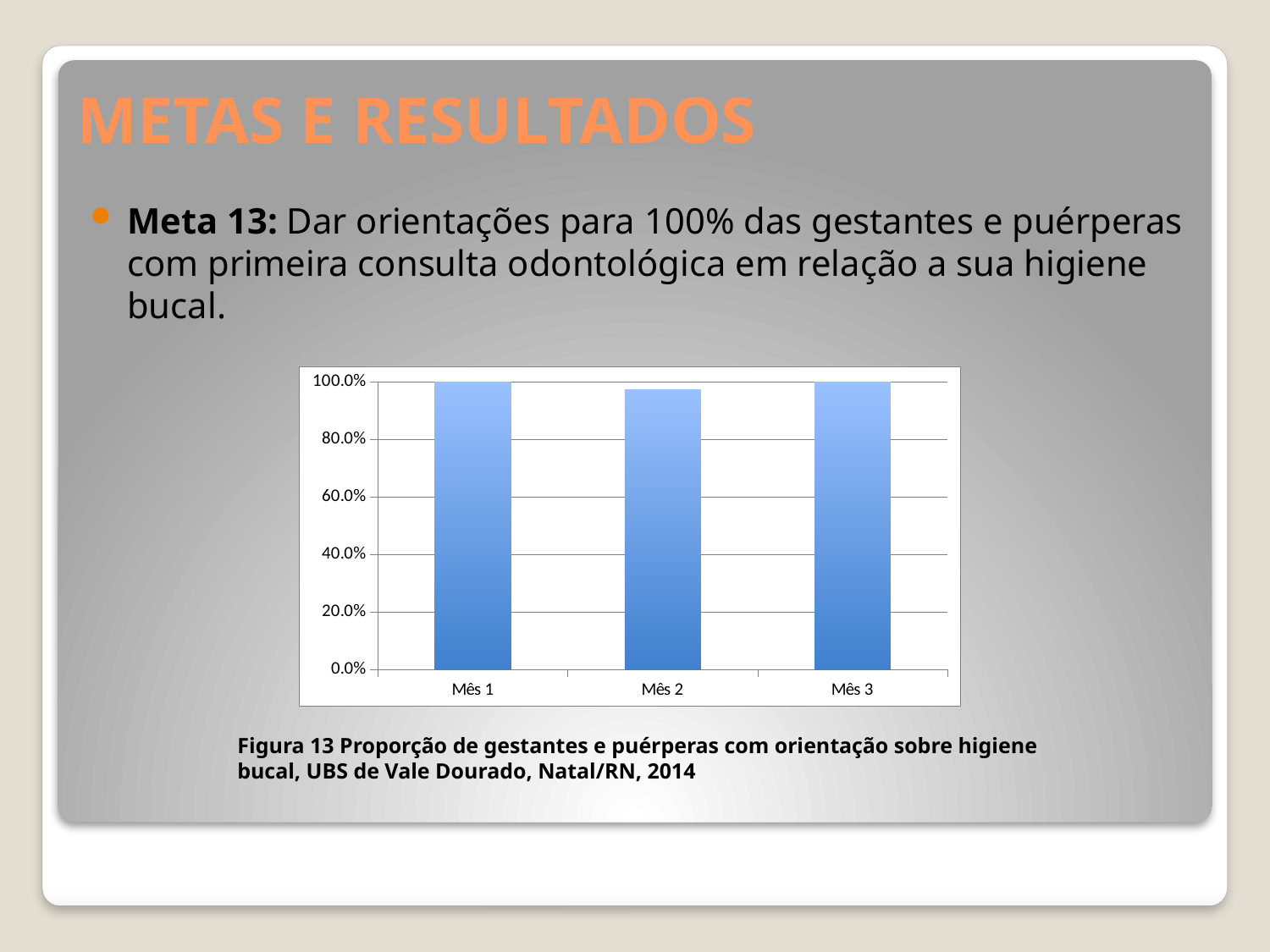
What is the highest value shown on the y axis of the chart? 100.0% Which month has the lowest value in the chart? Mês 2 What is the value for Mês 1 in the chart? 100.0% What is the value for Mês 3 in the chart? 100.0% What type of chart is shown on the slide? Bar chart What is the figure number given in the caption below the chart? Figura 13 How many categories (months) are shown on the x axis of the chart? 3 Is the value for Mês 1 larger or smaller than the value for Mês 2? larger Is the value for Mês 3 greater or less than 60.0%? greater Is the value for Mês 2 greater or less than 80.0%? greater